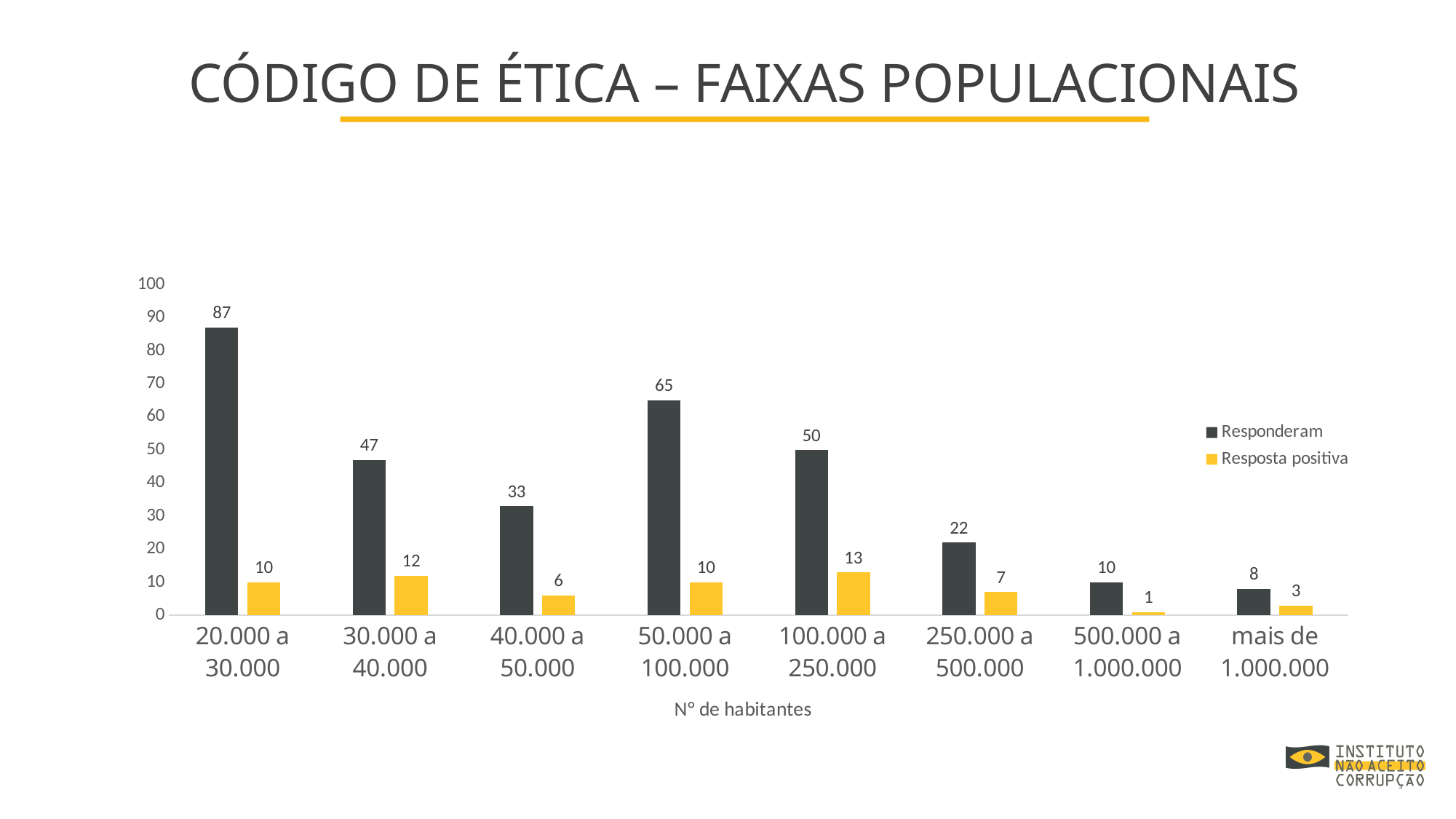
Is the Responderam value for 250.000 a 500.000 greater or less than 30? less Which is larger: Responderam for 30.000 a 40.000 or Responderam for 40.000 a 50.000? 30.000 a 40.000 What kind of chart is shown on the slide? bar chart Which category has the highest Responderam value? 20.000 a 30.000 How many population categories are shown on the x axis? 8 Which category has the lowest Resposta positiva value? 500.000 a 1.000.000 What is the value of Resposta positiva for the 100.000 a 250.000 category? 13 What is the value of Resposta positiva for the 500.000 a 1.000.000 category? 1 What is the value of Responderam for the 20.000 a 30.000 category? 87 What is the difference between Responderam and Resposta positiva for the 50.000 a 100.000 category? 55 What is the x-axis label of the chart? N° de habitantes How many series does the legend list? 2